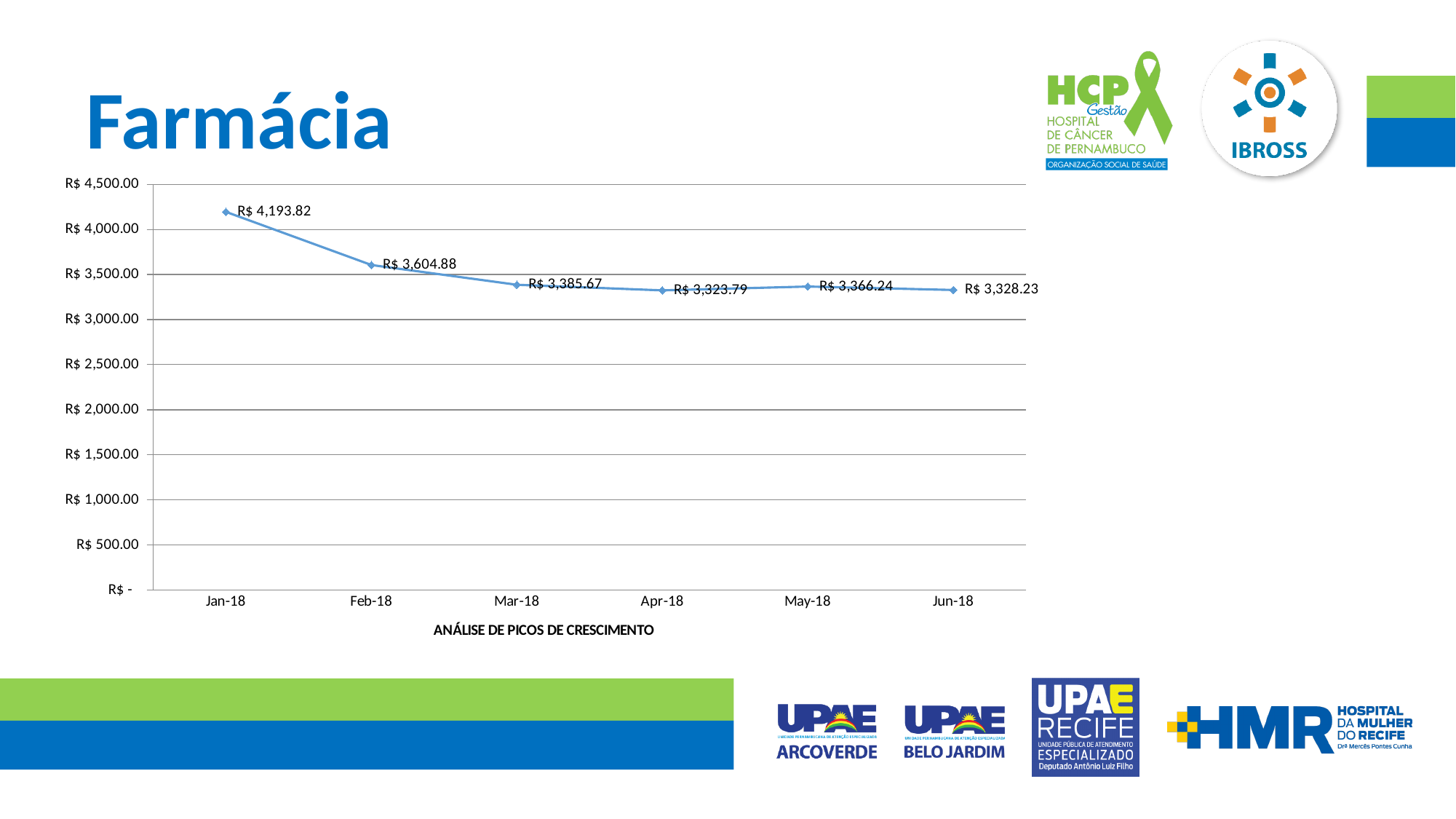
Which month has the lowest value? Apr-18 What is the difference between the values for Jan-18 and Feb-18? R$ 588.94 Which is larger, the value for Mar-18 or the value for Apr-18? Mar-18 How many months are plotted on the chart? 6 Which month has the highest value? Jan-18 What is the difference between the values for May-18 and Apr-18? R$ 42.45 What is the value for Jan-18? R$ 4,193.82 Do the values generally rise or fall from Jan-18 to Jun-18? fall What is the value for Apr-18? R$ 3,323.79 What kind of chart is shown on the slide? line chart What is the value for Jun-18? R$ 3,328.23 Is the value for Feb-18 greater or less than R$ 3,500.00? greater